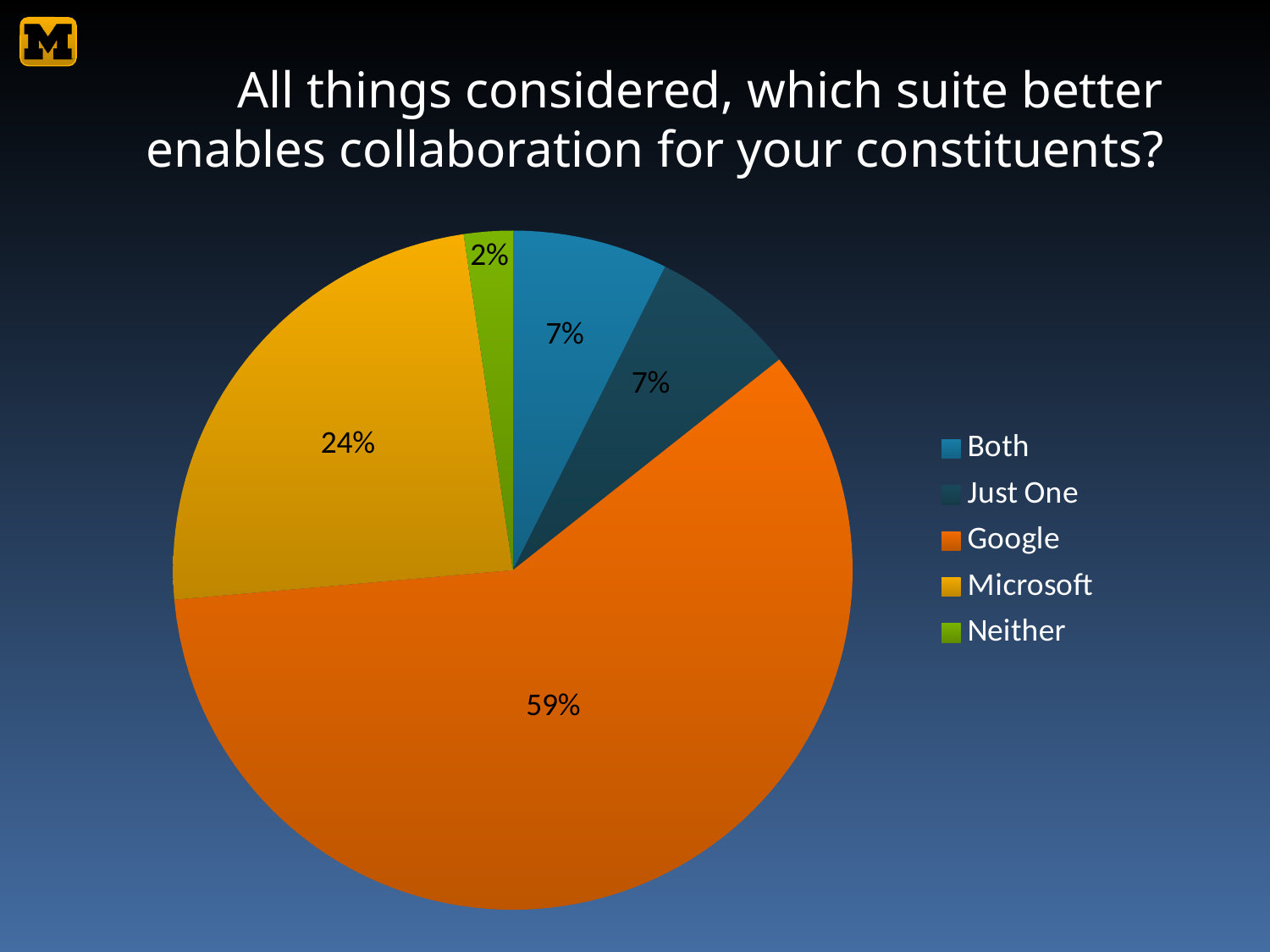
What colour is the Google slice in the pie chart? orange How many categories does the legend list? 5 What is the title of the chart? All things considered, which suite better enables collaboration for your constituents? Which category has the largest share of the pie? Google What percentage of the pie is labelled for Microsoft? 24% What type of chart is shown on the slide? pie chart What percentage of the pie is labelled for Neither? 2% What percentage of the pie is labelled for Both? 7% How many percentage points larger is the Google slice than the Microsoft slice? 35 Which category has the smallest share of the pie? Neither Which slice is larger, Microsoft or Just One? Microsoft What percentage of the pie is labelled for Google? 59%